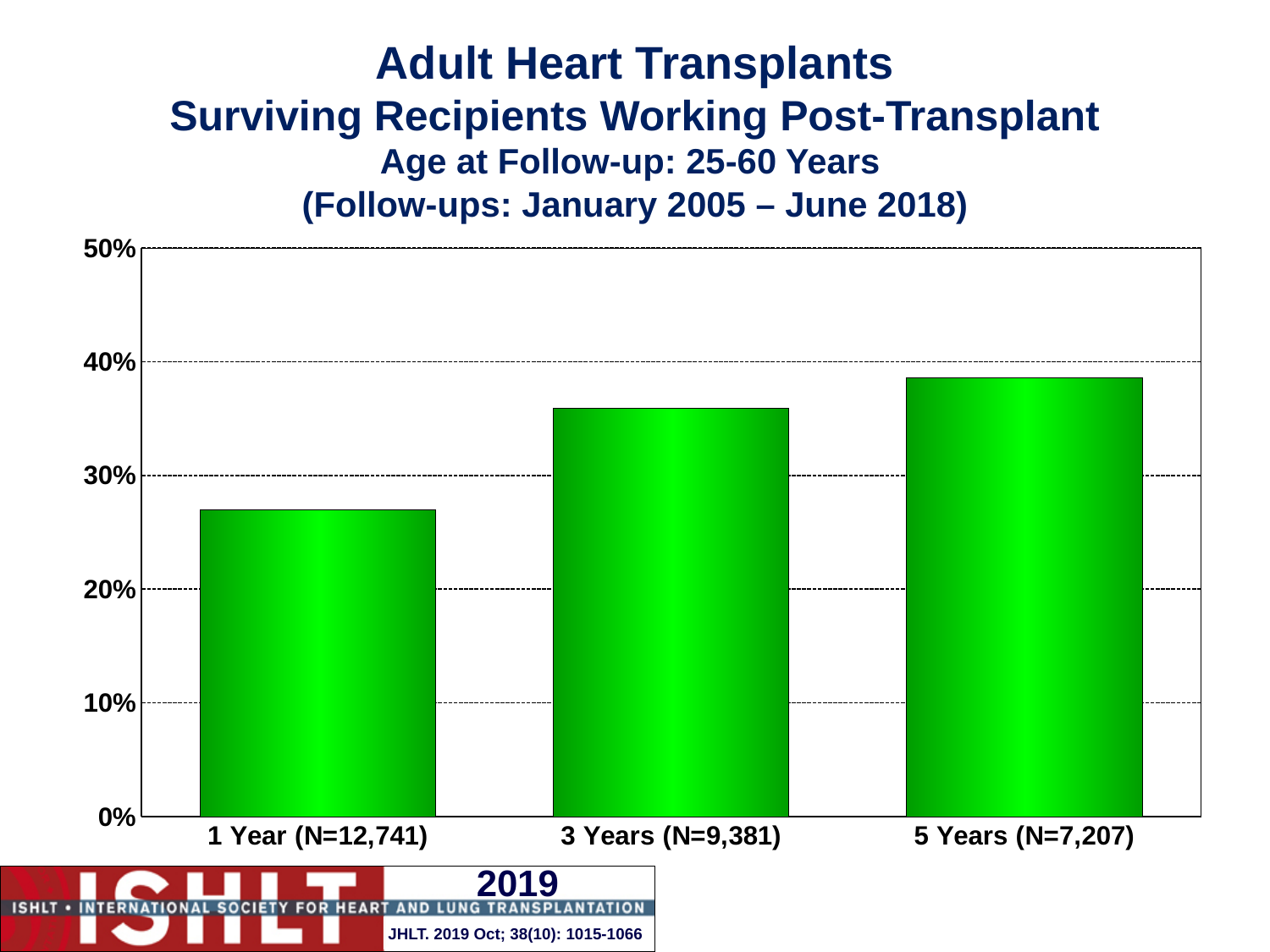
What is the age at follow-up range stated in the chart title? 25-60 Years Do the values rise or fall from 1 Year to 5 Years along the x axis? rise Is the value for 5 Years (N=7,207) greater or less than 40%? less What kind of chart is shown on the slide? bar chart Which category has the lowest value? 1 Year (N=12,741) Is the value for 1 Year (N=12,741) greater or less than 20%? greater What is the highest value shown on the y axis? 50% Is the value for 3 Years (N=9,381) greater or less than 30%? greater Which category has the highest value? 5 Years (N=7,207) Which is larger, the value for 1 Year (N=12,741) or the value for 3 Years (N=9,381)? 3 Years (N=9,381) How many categories are plotted on the x axis? 3